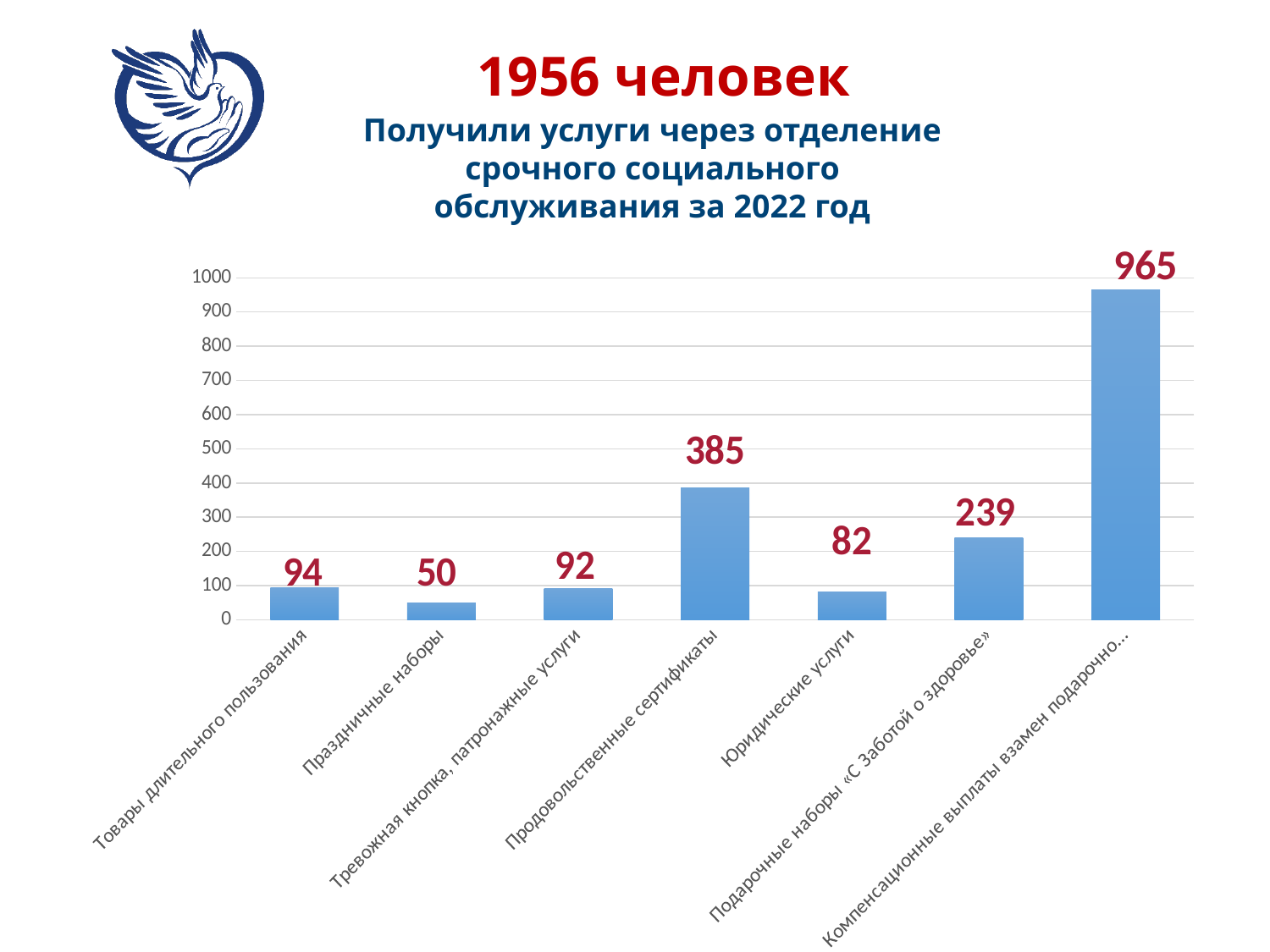
What total number of people is stated in the slide heading? 1956 человек Which category has the highest value? Компенсационные выплаты взамен подарочно... What value is shown for «Подарочные наборы «С заботой о здоровье»»? 239 Which category has the lowest value? Праздничные наборы What value is shown for «Праздничные наборы»? 50 How many categories are shown on the chart? 7 What is the difference between the values for «Продовольственные сертификаты» and «Подарочные наборы «С заботой о здоровье»»? 146 Is the value for «Тревожная кнопка, патронажные услуги» greater or less than 100? less Which is larger: the value for «Товары длительного пользования» or for «Юридические услуги»? Товары длительного пользования What kind of chart is shown on the slide? bar chart What value is shown for «Продовольственные сертификаты»? 385 What is the value of the rightmost bar? 965